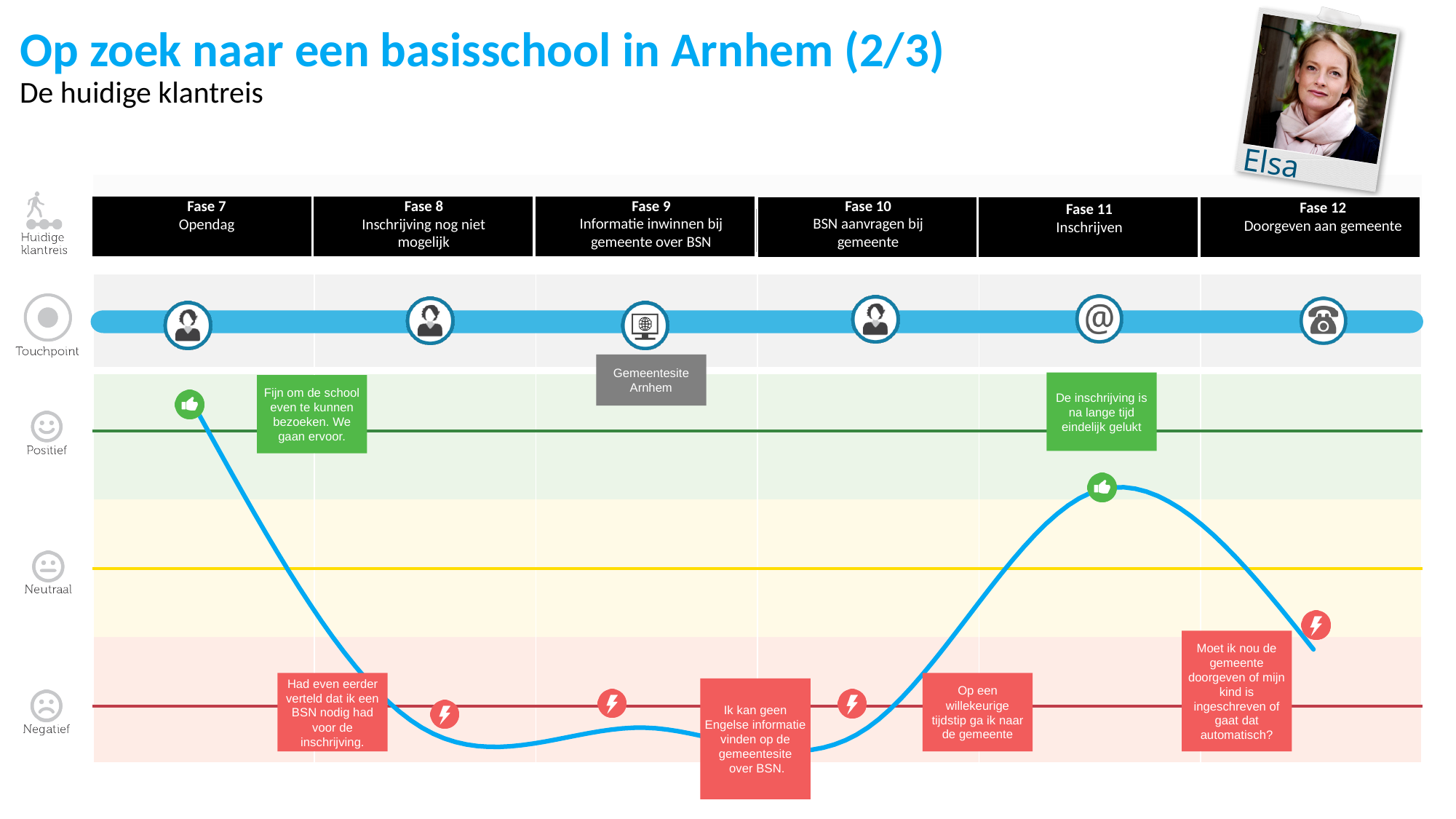
What kind of chart is used to show the customer's emotion across the phases? Line chart How many phases (fases) are shown along the top of the customer journey chart? 6 Does the emotion line rise or fall from Fase 7 to Fase 8? Fall Which phase has a higher emotion level, Fase 7 or Fase 11? Fase 7 Does the emotion line rise or fall from Fase 10 to Fase 11? Rise Is the emotion line in Fase 8 (Inschrijving nog niet mogelijk) in the positive or negative zone? Negative (Negatief) How many emotion levels are labelled on the vertical axis of the chart? 3 (Positief, Neutraal, Negatief) Does the emotion line rise or fall from Fase 11 to Fase 12? Fall What is the name of the touchpoint labelled under Fase 9? Gemeentesite Arnhem Is the emotion line in Fase 11 (Inschrijven) in the positive or negative zone? Positive (Positief) In which phase does the emotion line reach its highest point? Fase 7 (Opendag) What is the title of Fase 12? Doorgeven aan gemeente